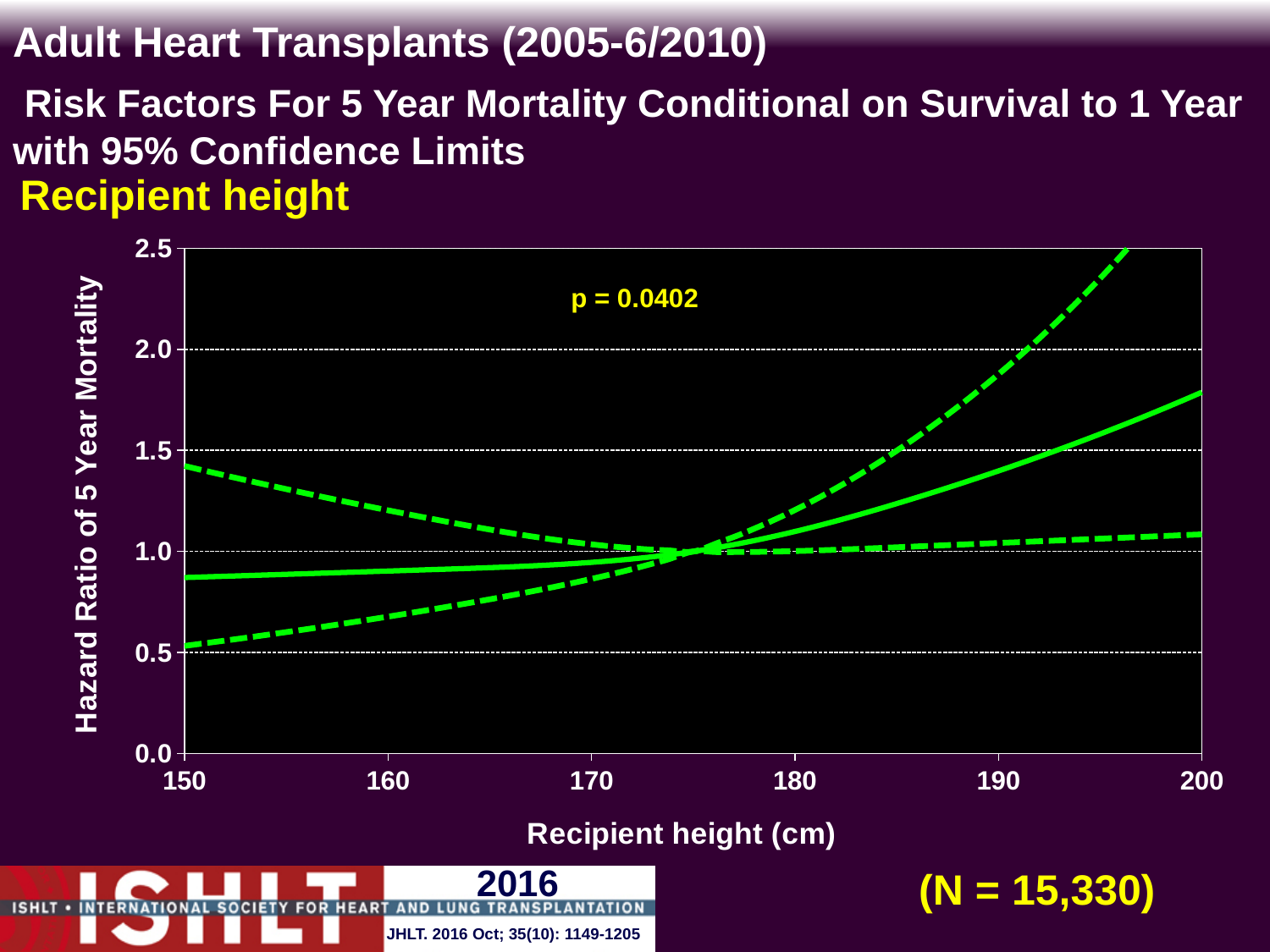
Is the lower dashed confidence limit at 150 cm greater or less than 1.0? less Does the solid hazard ratio line rise or fall as recipient height increases from 150 cm to 200 cm? rises What kind of chart is shown on the slide? line chart Is the hazard ratio on the solid line higher at 200 cm or at 150 cm? 200 cm Is the hazard ratio on the solid line at 200 cm greater or less than 1.5? greater What sample size (N) is shown on the slide? N = 15,330 Is the hazard ratio on the solid line at 150 cm greater or less than 1.0? less How many lines are plotted on the chart? 3 What p-value is printed on the chart? p = 0.0402 Is the upper dashed confidence limit at 200 cm higher or lower than the lower dashed confidence limit at 200 cm? higher